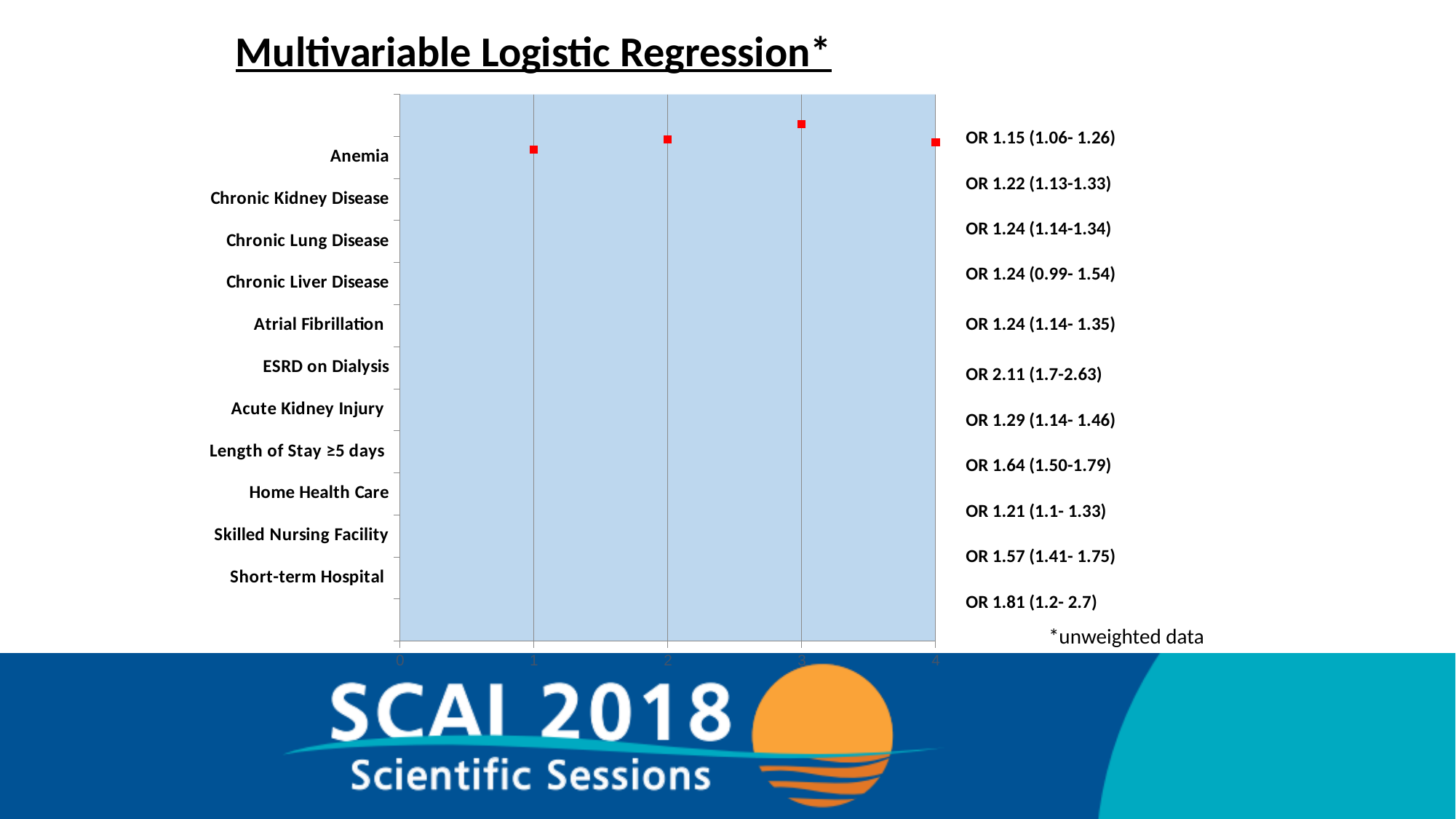
What odds ratio is printed next to the chart for Anemia? OR 1.15 (1.06- 1.26) What odds ratio is printed next to the chart for Short-term Hospital? OR 1.81 (1.2- 2.7) What odds ratio is printed next to the chart for Length of Stay ≥5 days? OR 1.64 (1.50-1.79) What is the highest tick value shown on the horizontal axis of the chart? 4 Which category has the lowest odds ratio printed on the slide? Anemia What is the difference between the odds ratio for ESRD on Dialysis and the odds ratio for Anemia? 0.96 What odds ratio is printed next to the chart for ESRD on Dialysis? OR 2.11 (1.7-2.63) What is the title of the chart on the slide? Multivariable Logistic Regression* Which category has the highest odds ratio printed on the slide? ESRD on Dialysis How many categories are listed on the vertical axis of the chart? 11 How many red square markers are plotted in the chart area? 4 Which has the larger odds ratio, Short-term Hospital or Skilled Nursing Facility? Short-term Hospital